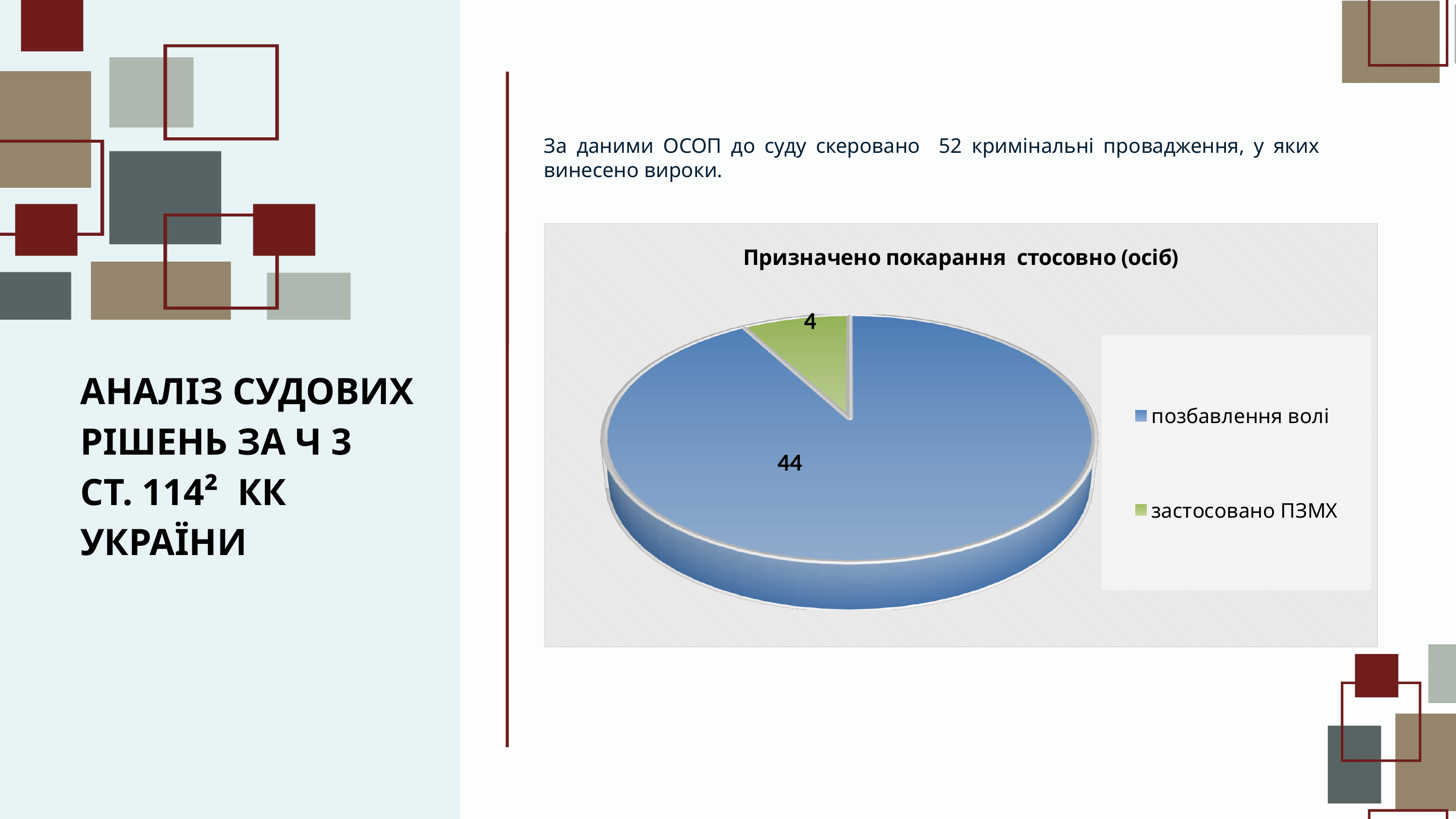
What is the value for позбавлення волі? 44 What is the title of the chart? Призначено покарання стосовно (осіб) What is the value for застосовано ПЗМХ? 4 How many slices does the pie chart have? 2 Which category has the smallest slice of the pie? застосовано ПЗМХ What colour is the slice for застосовано ПЗМХ? green What is the total of all slices in the pie chart? 48 What type of chart is shown on the slide? pie chart Which category has the largest slice of the pie? позбавлення волі How many entries does the chart legend list? 2 What is the difference between the values for позбавлення волі and застосовано ПЗМХ? 40 Which is larger, the value for позбавлення волі or the value for застосовано ПЗМХ? позбавлення волі